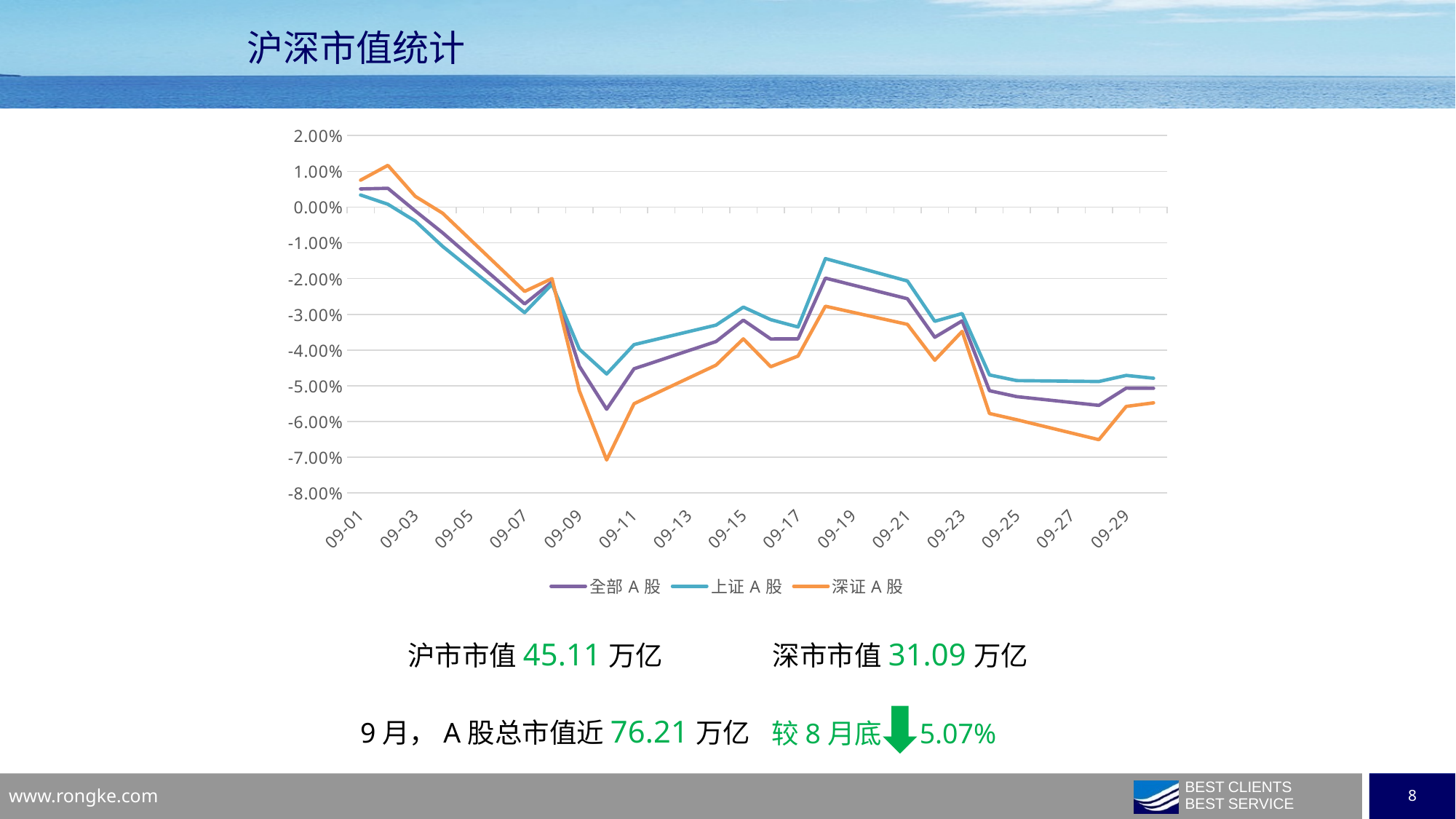
Is the value for 深证A股 at 09-03 greater or less than 0.00%? greater Is the value for 全部A股 at 09-29 greater or less than -4.00%? less What is the title of the slide containing the chart? 沪深市值统计 At 09-27, which series has the higher value, 上证A股 or 深证A股? 上证A股 How many series does the chart legend list? 3 What kind of chart is shown on the slide? line chart Overall, do the values of 全部A股 rise or fall from 09-01 to 09-29? fall How many date labels are shown on the x axis of the chart? 15 Is the value for 上证A股 at 09-01 greater or less than 0.00%? greater What are the three series listed in the chart legend? 全部A股, 上证A股, 深证A股 Which series reaches the lowest point on the chart? 深证A股